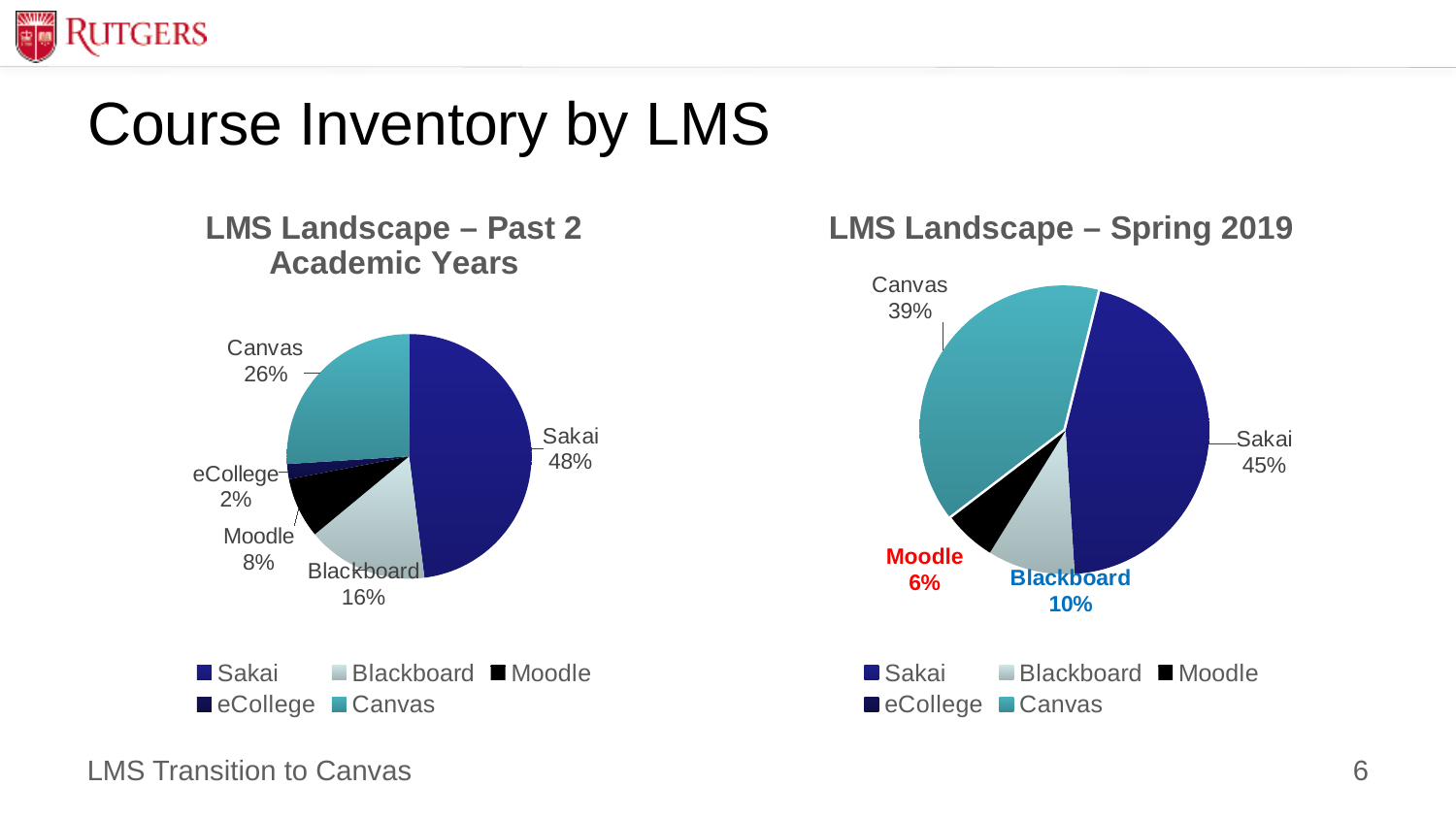
In the 'LMS Landscape – Past 2 Academic Years' chart, what is the difference between the Sakai and Blackboard shares? 32% In the 'LMS Landscape – Past 2 Academic Years' chart, what share does Sakai have? 48% In the 'LMS Landscape – Spring 2019' chart, what share does Blackboard have? 10% What kind of chart is 'LMS Landscape – Spring 2019'? Pie chart In the 'LMS Landscape – Spring 2019' chart, what is the difference between the Sakai and Canvas shares? 6% In the 'LMS Landscape – Past 2 Academic Years' chart, which LMS has the smallest share? eCollege In the 'LMS Landscape – Spring 2019' chart, what share does Canvas have? 39% In the 'LMS Landscape – Past 2 Academic Years' chart, what share does Canvas have? 26% In the 'LMS Landscape – Spring 2019' chart, which LMS has the largest share? Sakai In the 'LMS Landscape – Past 2 Academic Years' chart, what share does eCollege have? 2% In the 'LMS Landscape – Spring 2019' chart, which is larger, the Moodle share or the Blackboard share? Blackboard How many entries does the legend of the 'LMS Landscape – Past 2 Academic Years' chart list? 5